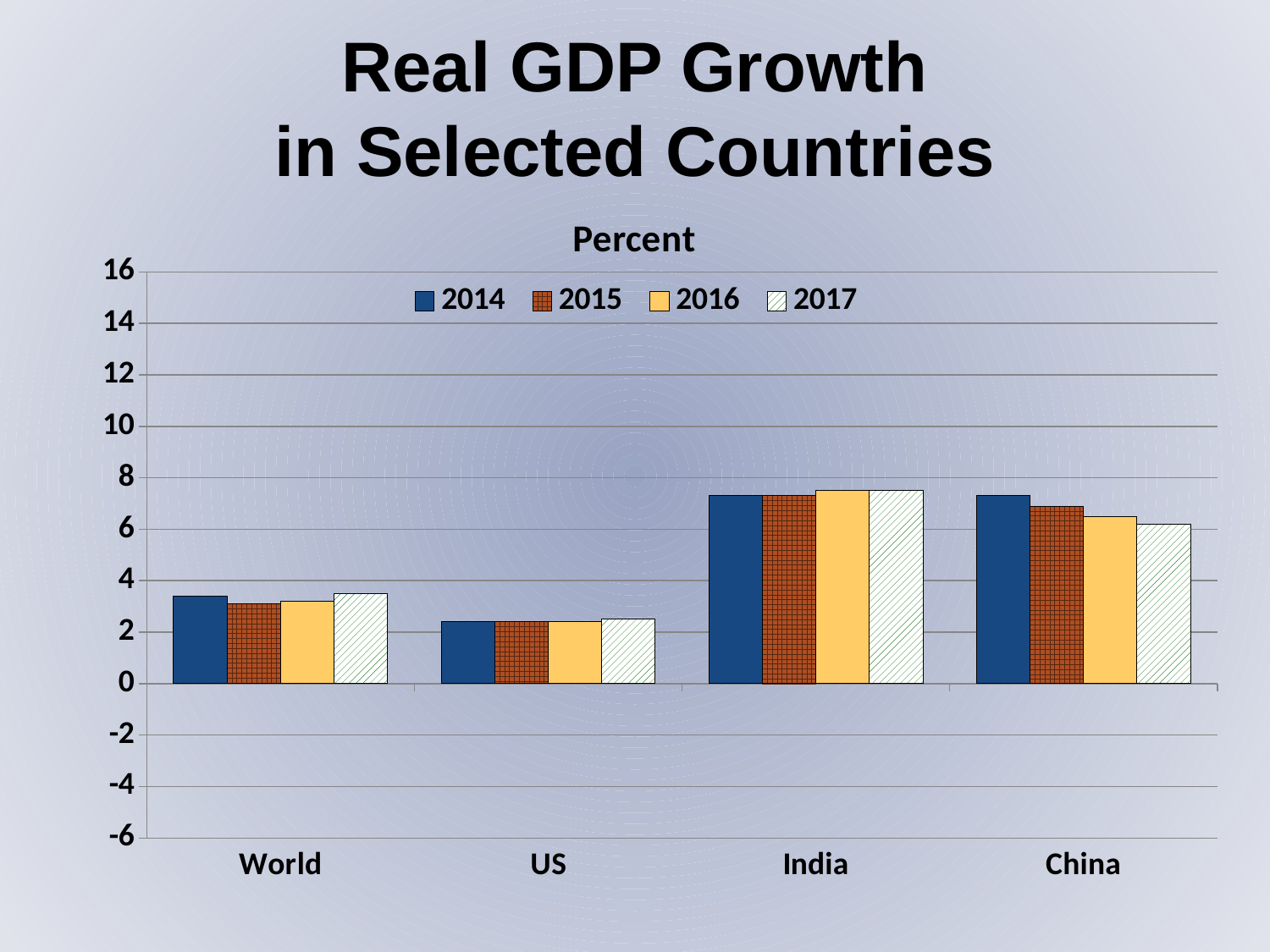
What kind of chart is shown on the slide? bar chart Which is larger in 2014, the value for China or the value for US? China Is the value for US in 2014 greater or less than 4? less What is the title of the slide? Real GDP Growth in Selected Countries Is the value for China in 2017 greater or less than 8? less Is the value for India in 2016 greater or less than 6? greater How many series does the legend list? 4 Do the values for China rise or fall from 2014 to 2017? fall Which country or region has the lowest value for 2014? US Which is larger in 2017, the value for India or the value for China? India How many countries or regions are shown on the x axis? 4